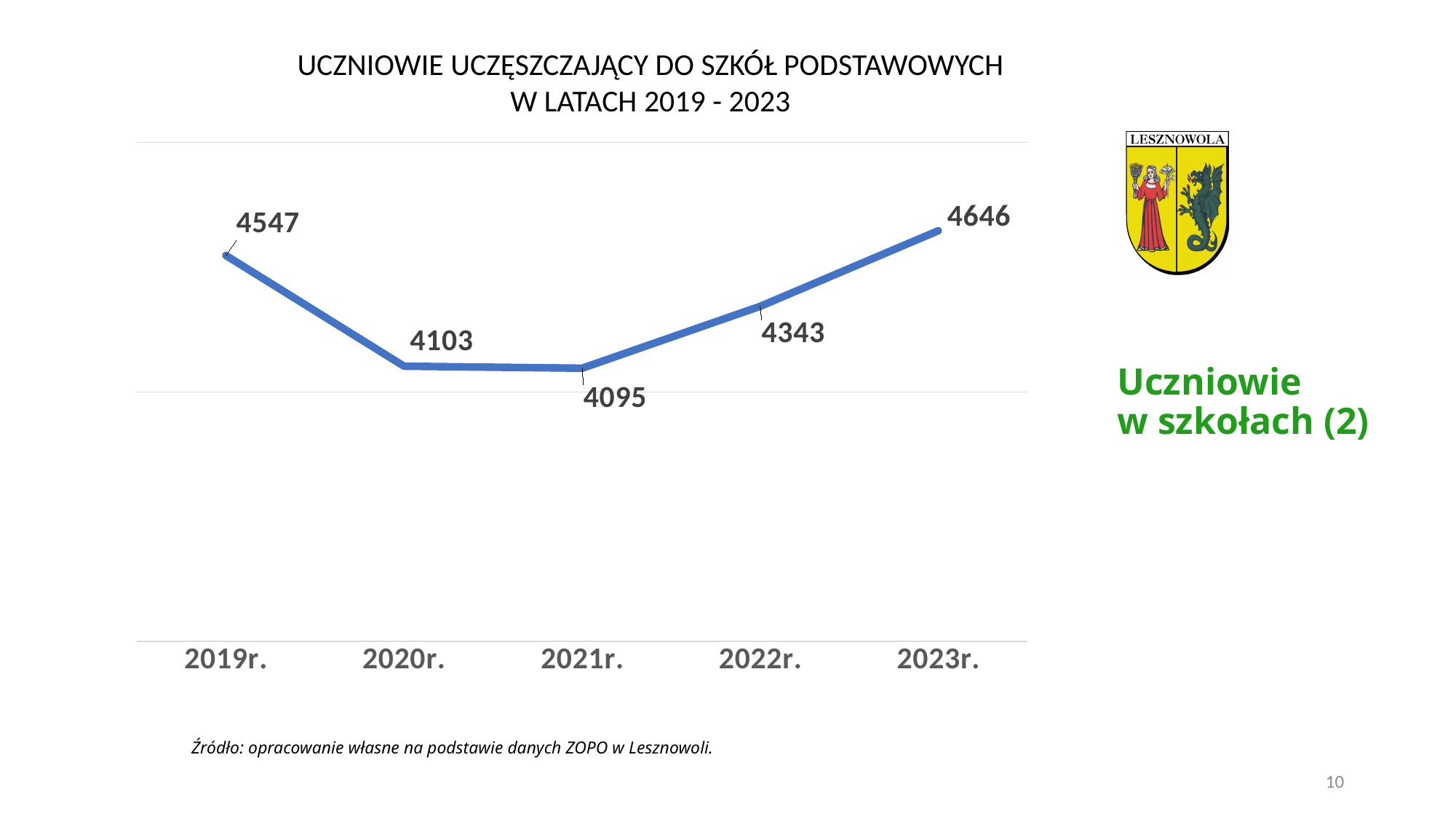
What is the number of primary school pupils in 2023r.? 4646 What is the title of the chart? UCZNIOWIE UCZĘSZCZAJĄCY DO SZKÓŁ PODSTAWOWYCH W LATACH 2019 - 2023 Which year has the lowest number of pupils? 2021r. What is the number of primary school pupils in 2019r.? 4547 Which year has the highest number of pupils? 2023r. What is the number of primary school pupils in 2021r.? 4095 Do the values rise or fall from 2021r. to 2023r.? rise How many years are plotted on the chart? 5 What kind of chart is shown on the slide? line chart What is the difference between the number of pupils in 2022r. and 2021r.? 248 Which year has more pupils, 2020r. or 2022r.? 2022r. What is the difference between the number of pupils in 2023r. and 2019r.? 99